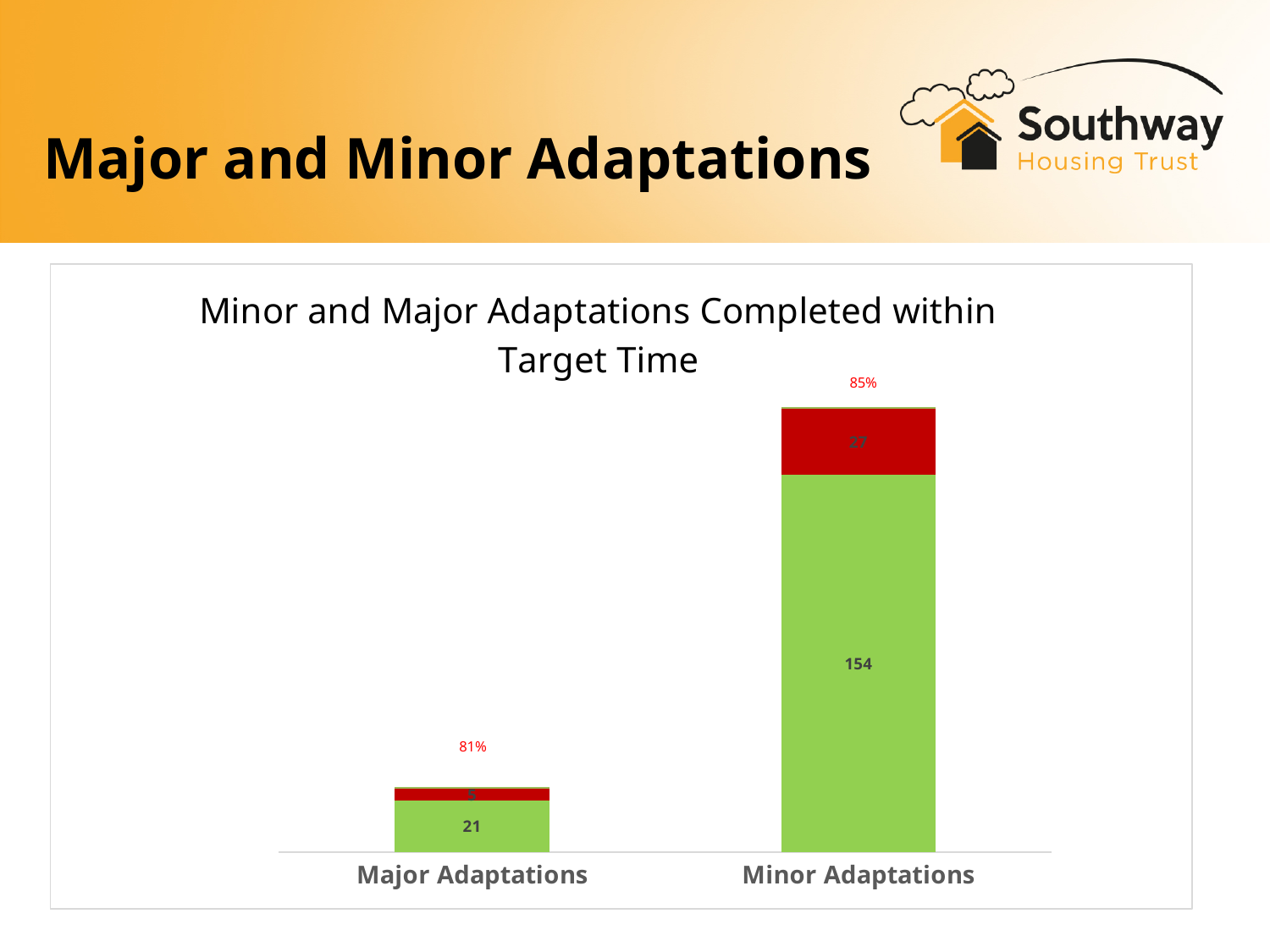
What is the value of the green segment for Major Adaptations? 21 What percentage is shown above the Minor Adaptations bar? 85% Which category has the taller bar? Minor Adaptations What is the difference between the green segment values for Minor Adaptations and Major Adaptations? 133 How many categories are shown on the x axis of the chart? 2 What is the total of the stacked bar for Minor Adaptations? 181 Which category has the shorter bar? Major Adaptations What percentage is shown above the Major Adaptations bar? 81% What is the value of the red segment for Minor Adaptations? 27 What is the title of the chart? Minor and Major Adaptations Completed within Target Time What type of chart is shown on the slide? Stacked bar chart What is the value of the green segment for Minor Adaptations? 154